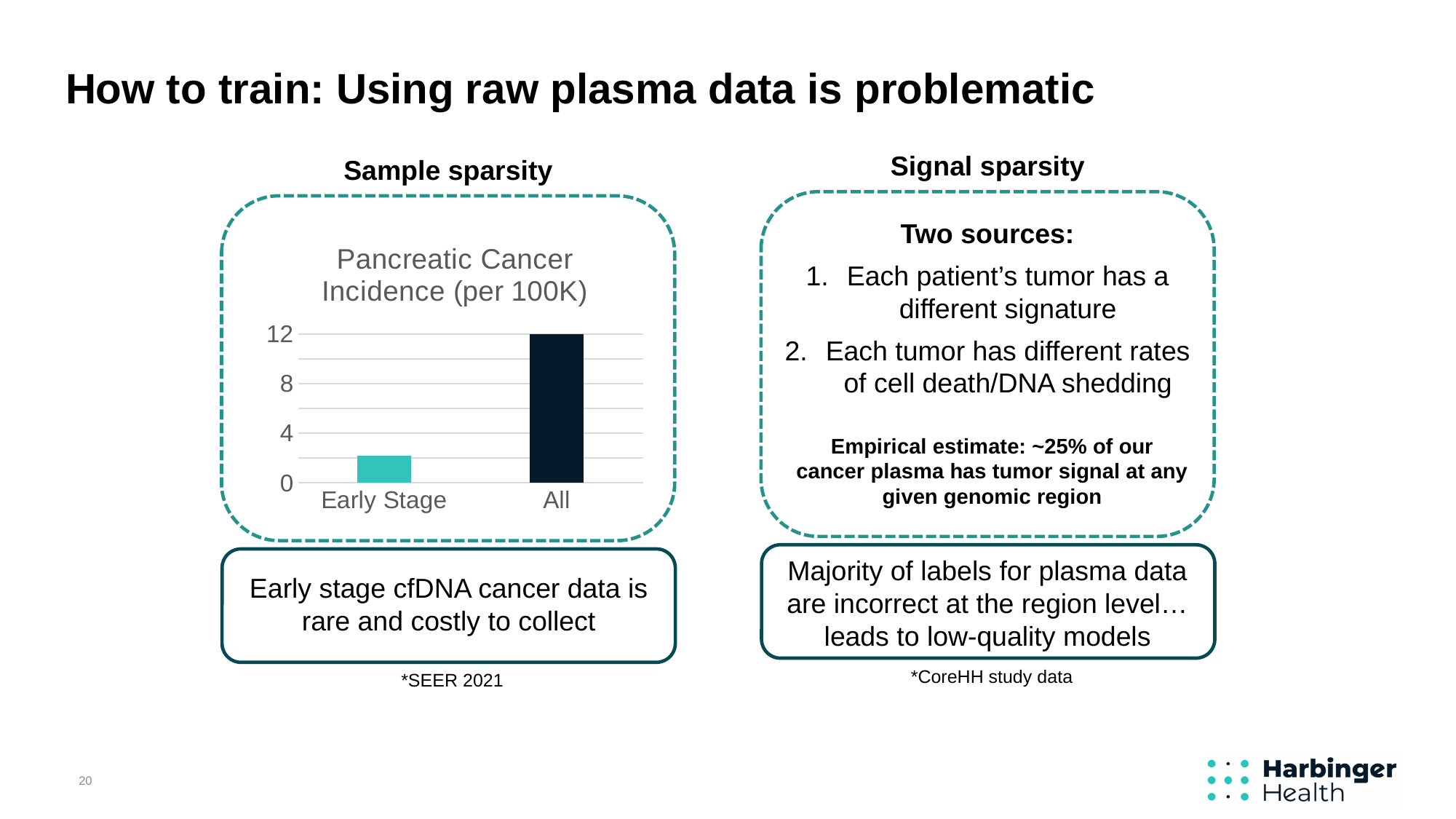
How many categories are plotted in the Pancreatic Cancer Incidence chart? 2 What colour is the Early Stage bar in the Pancreatic Cancer Incidence chart? teal What kind of chart is shown under "Sample sparsity"? bar chart Which category has the lowest value in the Pancreatic Cancer Incidence chart? Early Stage Is the value for Early Stage in the Pancreatic Cancer Incidence chart greater or less than 4? less In the Pancreatic Cancer Incidence chart, which is larger: Early Stage or All? All Which category has the highest value in the Pancreatic Cancer Incidence chart? All What is the value for All in the Pancreatic Cancer Incidence chart? 12 Is the value for All in the Pancreatic Cancer Incidence chart greater or less than 8? greater What is the title of the chart on the slide? Pancreatic Cancer Incidence (per 100K) What is the highest value labelled on the y axis of the Pancreatic Cancer Incidence chart? 12